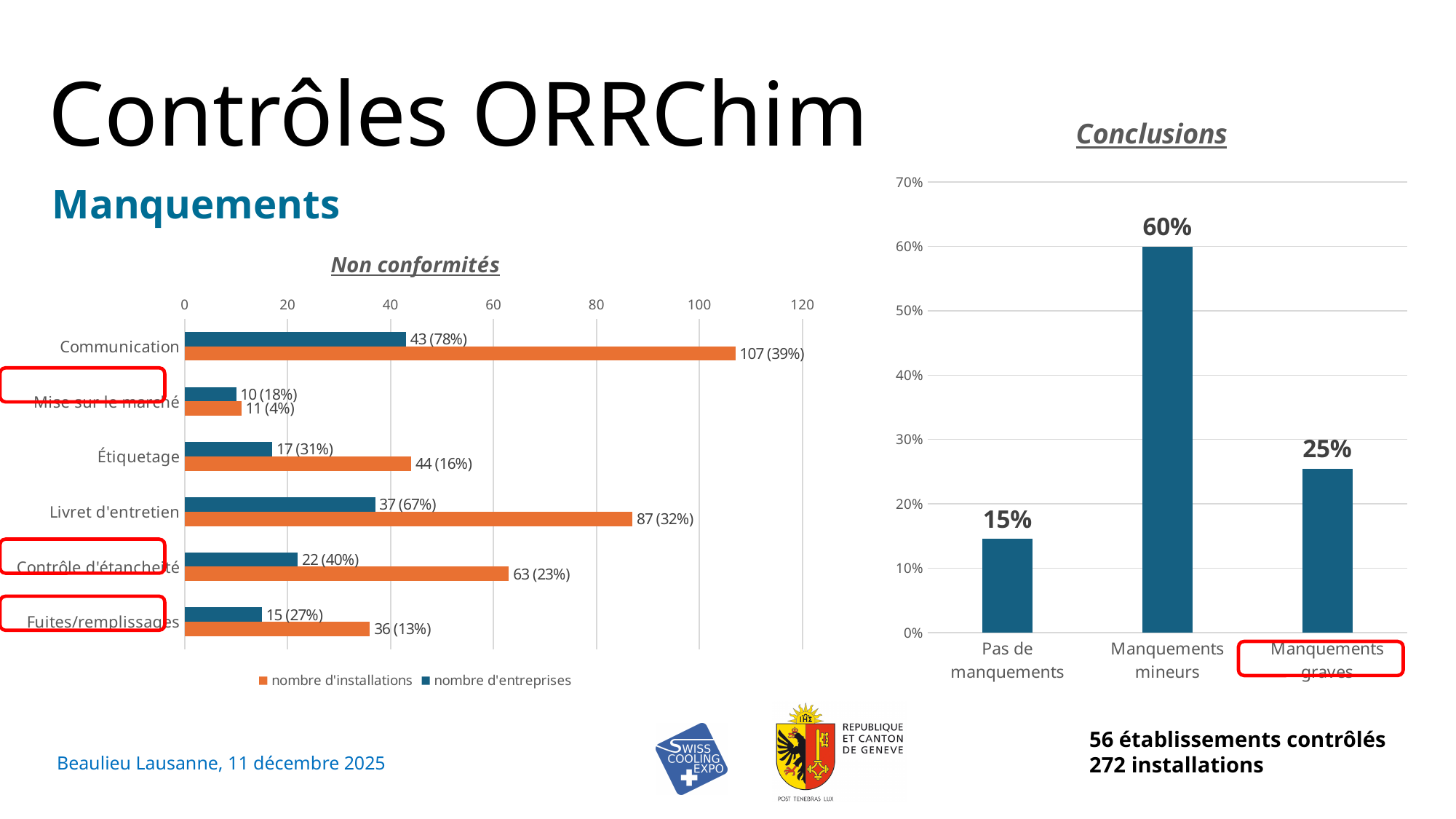
How many categories are shown in the 'Non conformités' chart? 6 In the 'Non conformités' chart, what is the data label for 'nombre d'entreprises' for Livret d'entretien? 37 (67%) What kind of chart is the 'Conclusions' chart? Bar chart In the 'Non conformités' chart, which is larger for Étiquetage: 'nombre d'installations' or 'nombre d'entreprises'? nombre d'installations In the 'Conclusions' chart, which category has the lowest value? Pas de manquements In the 'Non conformités' chart, which category has the highest value for 'nombre d'installations'? Communication In the 'Non conformités' chart, what is the difference between the 'nombre d'installations' values for Livret d'entretien (87) and Contrôle d'étanchéité (63)? 24 In the 'Non conformités' chart, which category has the lowest value for 'nombre d'entreprises'? Mise sur le marché In the 'Conclusions' chart, what is the value for 'Manquements mineurs'? 60% In the 'Conclusions' chart, what is the difference between 'Manquements mineurs' (60%) and 'Manquements graves' (25%)? 35% In the 'Non conformités' chart, what is the data label for 'nombre d'installations' for Communication? 107 (39%) How many series does the legend of the 'Non conformités' chart list? 2